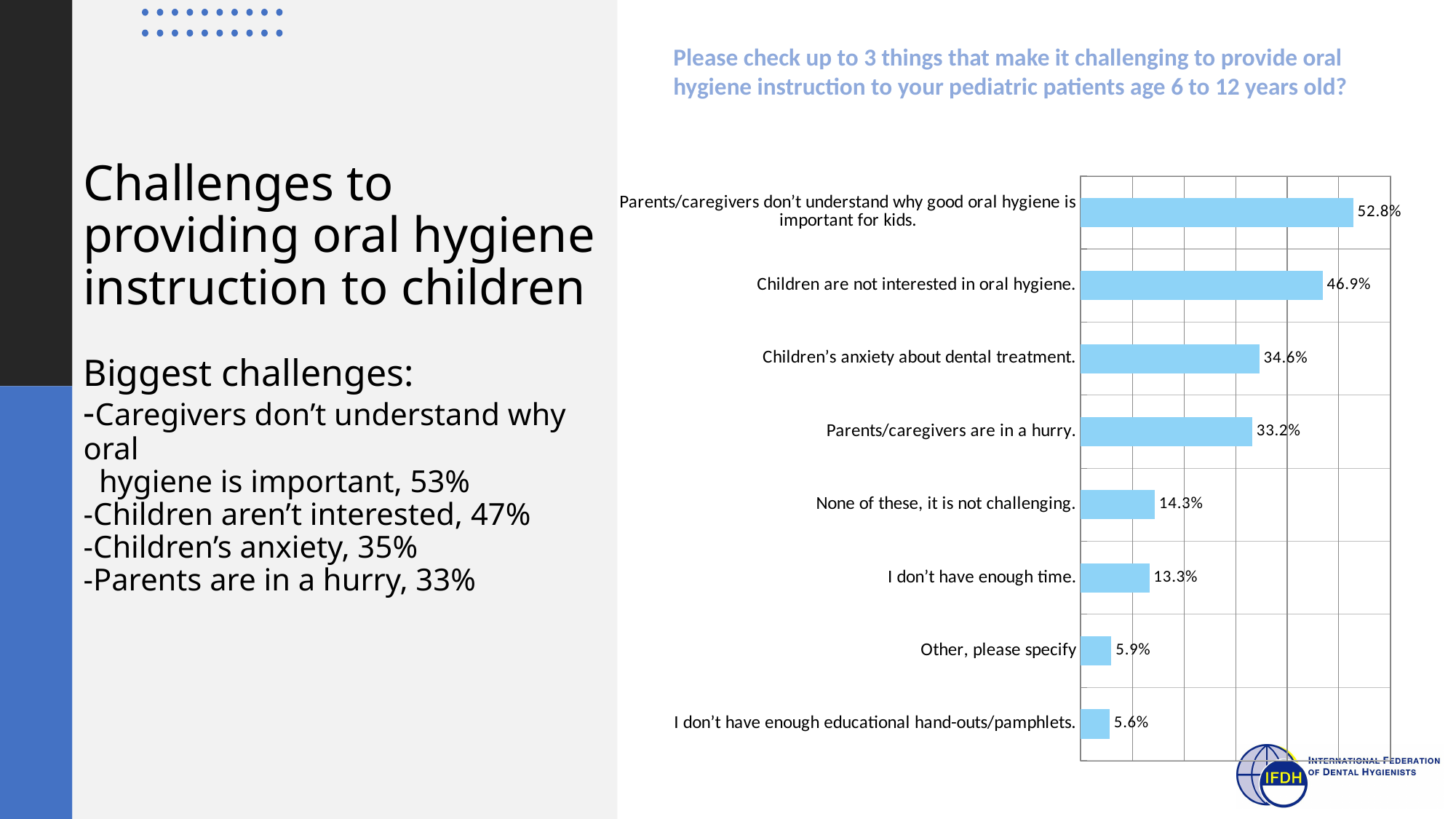
What is the difference between the percentages for "Children's anxiety about dental treatment." and "Parents/caregivers are in a hurry."? 1.4% What percentage of respondents selected "Children are not interested in oral hygiene." as a challenge? 46.9% Which challenge has the highest percentage in the chart? Parents/caregivers don't understand why good oral hygiene is important for kids. What percentage is shown for "I don't have enough time."? 13.3% Which category has the lowest percentage in the chart? I don't have enough educational hand-outs/pamphlets. How many categories are shown in the bar chart? 8 Which has a larger percentage: "None of these, it is not challenging." or "I don't have enough time."? None of these, it is not challenging. What is the value shown for "Parents/caregivers are in a hurry."? 33.2% What is the difference between the highest value (52.8%) and the value for "Children are not interested in oral hygiene."? 5.9% What is the value shown for "Other, please specify"? 5.9% What type of chart is shown on the slide? Bar chart What colour are the bars in the chart? Light blue